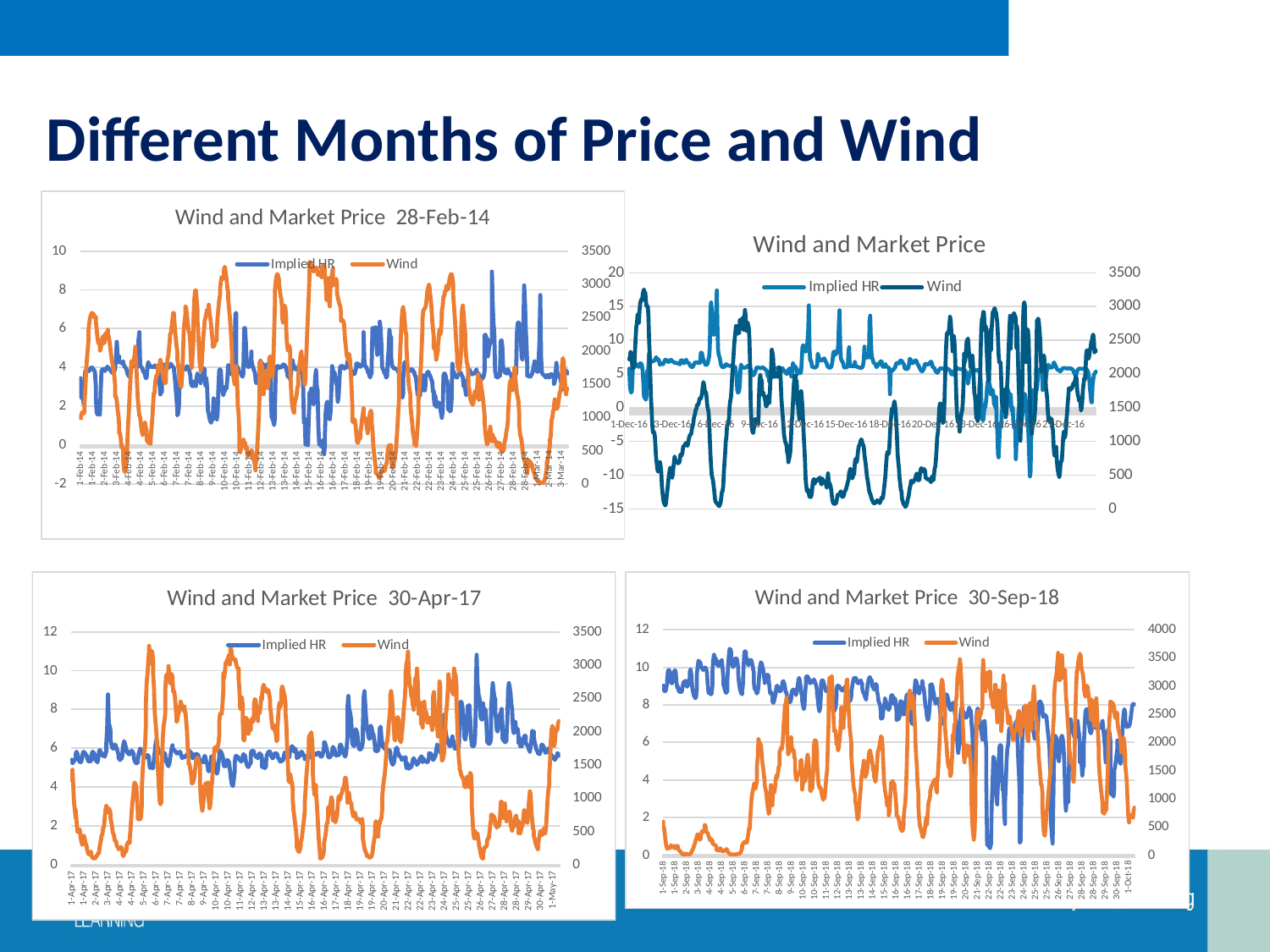
In the 'Wind and Market Price 30-Apr-17' chart, how many series does the legend list? 2 What type of chart is the bottom-right chart titled 'Wind and Market Price 30-Sep-18'? Line chart What type of chart is the top-left chart titled 'Wind and Market Price 28-Feb-14'? Line chart In the 'Wind and Market Price 30-Sep-18' chart, is the Wind value at 1-Sep-18 greater or less than 1000? less In the 'Wind and Market Price 30-Apr-17' chart, is the Implied HR value at 1-Apr-17 greater or less than 8? less In the top-right chart titled 'Wind and Market Price', how many series does the legend list? 2 In the 'Wind and Market Price 30-Sep-18' chart, what are the two legend entries? Implied HR and Wind In the 'Wind and Market Price 28-Feb-14' chart, is the Wind value at 1-Feb-14 greater or less than 2500? less In the 'Wind and Market Price 30-Sep-18' chart, what is the maximum value shown on the right-hand axis? 4000